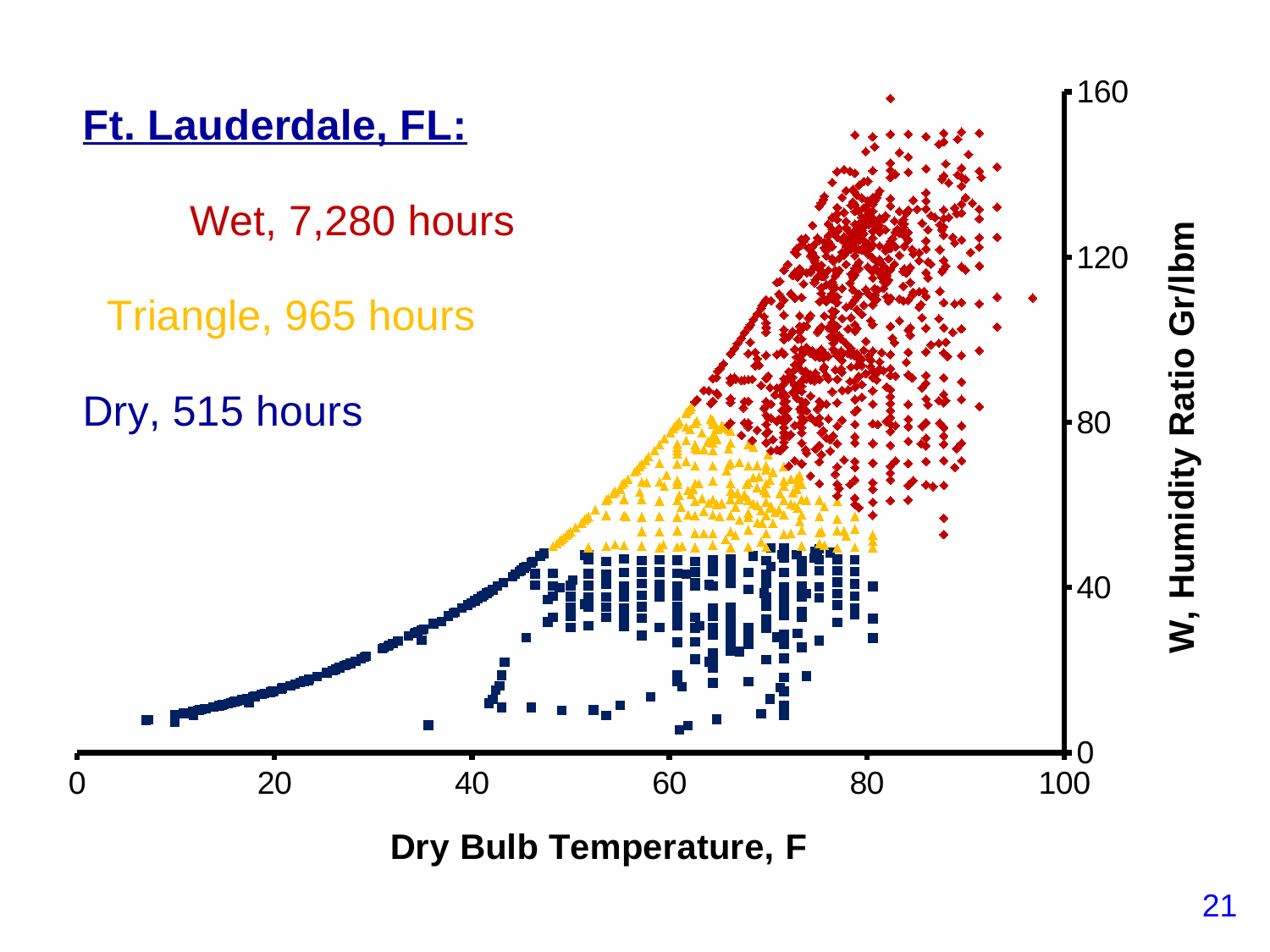
Which series has the fewest hours? Dry How many hours are listed for the Wet series? 7,280 hours How many data series (Wet, Triangle, Dry) are plotted on the chart? 3 Which series has the most hours? Wet Which series has more hours, Triangle or Dry? Triangle How many hours are listed for the Dry series? 515 hours How many hours are listed for the Triangle series? 965 hours What is the label of the x axis? Dry Bulb Temperature, F What is the difference in hours between the Wet and Triangle series? 6,315 hours What kind of chart is shown on the slide? scatter chart What colour are the markers for the Dry series? blue Is the humidity ratio of the highest red (Wet) point greater or less than 140? greater